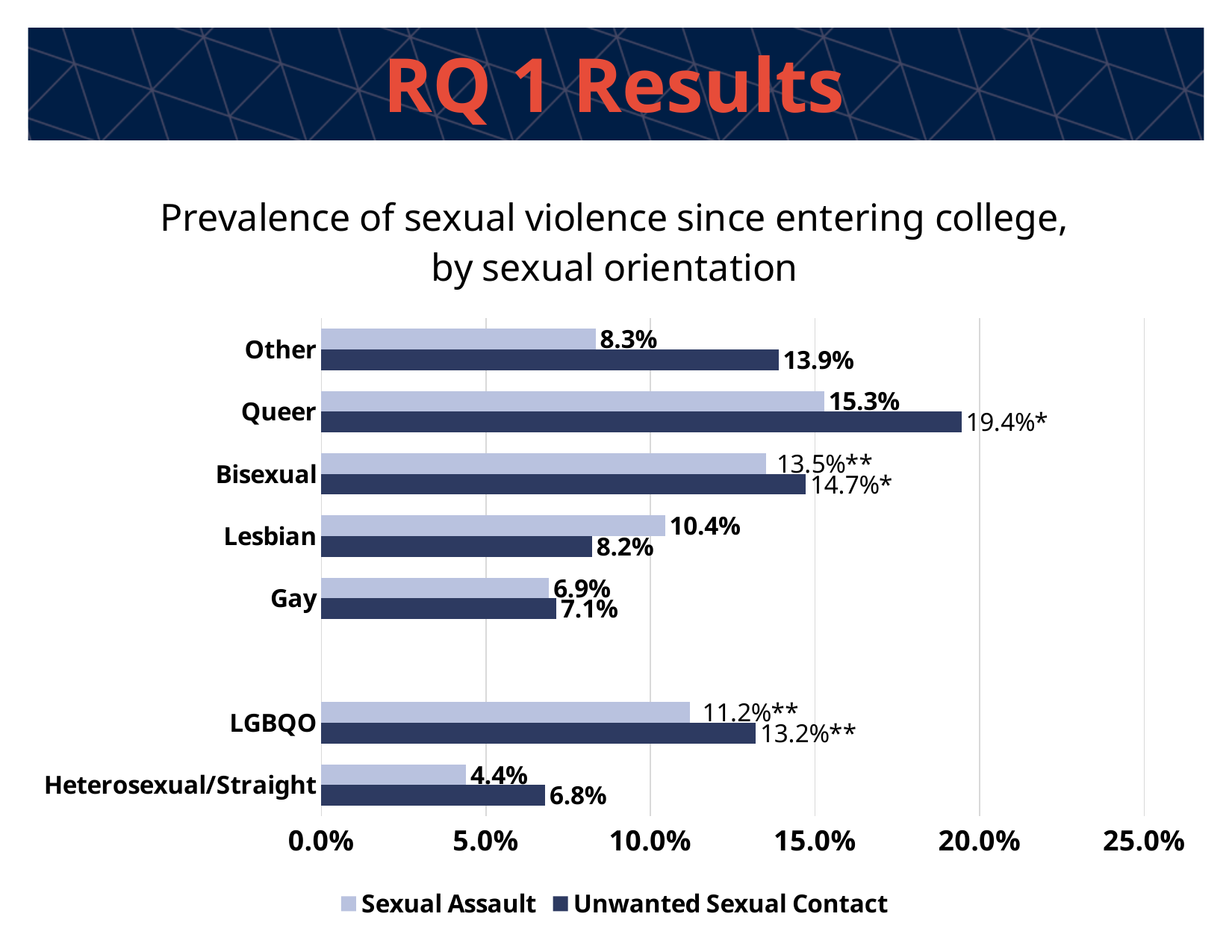
What is the Sexual Assault prevalence for the Lesbian group? 10.4% What is the Sexual Assault prevalence for the Heterosexual/Straight group? 4.4% How many sexual orientation categories are plotted on the chart? 7 What is the Unwanted Sexual Contact prevalence for the Other group? 13.9% For the Lesbian group, which is larger: Sexual Assault or Unwanted Sexual Contact? Sexual Assault Is the Unwanted Sexual Contact value for the Queer group greater or less than 15.0%? greater What is the difference between Unwanted Sexual Contact and Sexual Assault prevalence for the Other group? 5.6 percentage points Which group has the highest Unwanted Sexual Contact prevalence? Queer What is the title of the chart? Prevalence of sexual violence since entering college, by sexual orientation What type of chart is shown on the slide? Bar chart Which group has the lowest Sexual Assault prevalence? Heterosexual/Straight How many series does the legend list? 2